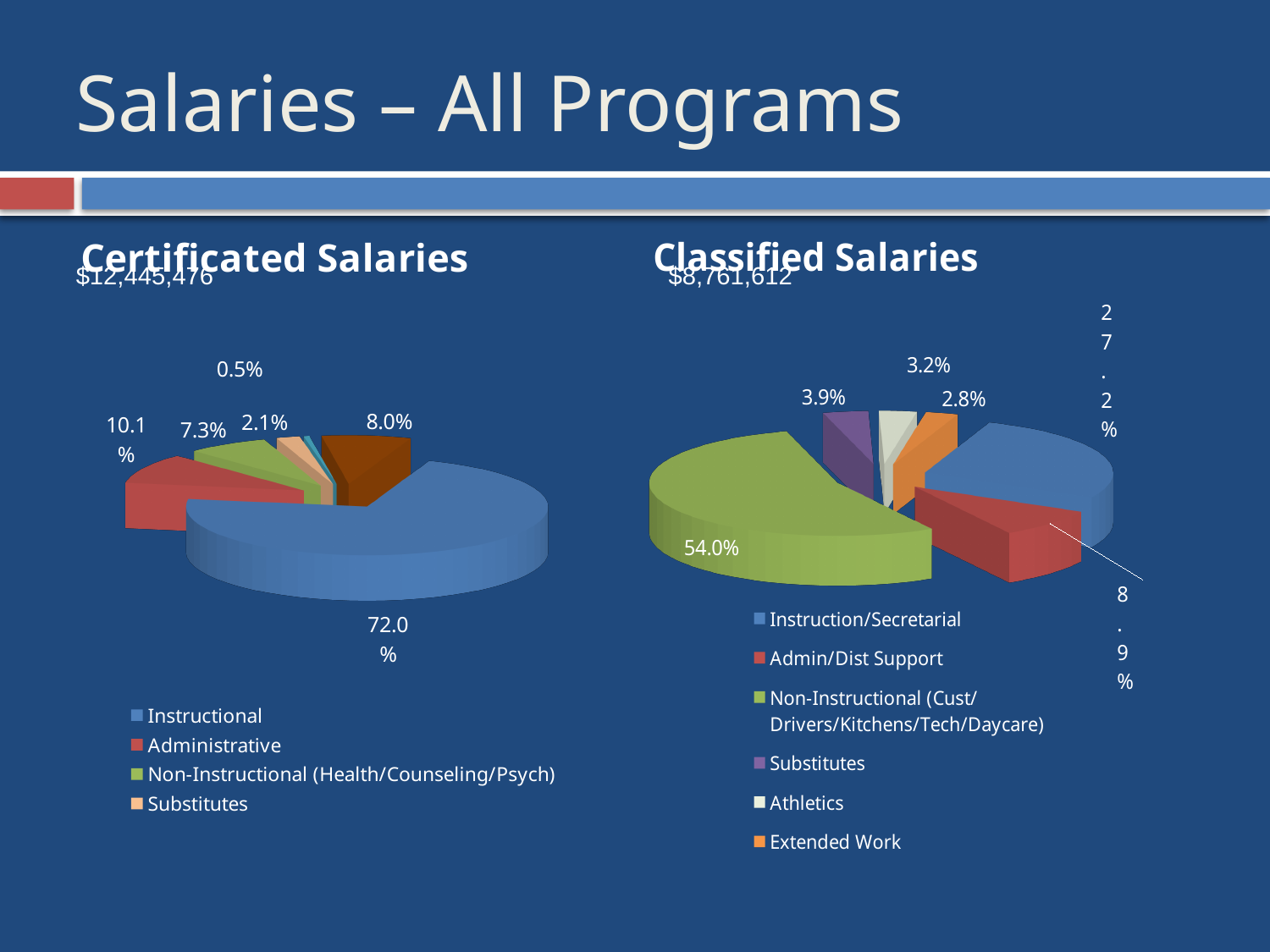
In the Certificated Salaries chart, which category has the largest slice? Instructional In the Certificated Salaries chart, what share is Instructional? 72.0% In the Classified Salaries chart, what share is Admin/Dist Support? 8.9% How many categories does the legend of the Classified Salaries chart list? 6 In the Classified Salaries chart, what share is Instruction/Secretarial? 27.2% In the Classified Salaries chart, which category has the smallest slice? Extended Work In the Certificated Salaries chart, which is larger, Administrative or Non-Instructional (Health/Counseling/Psych)? Administrative In the Classified Salaries chart, what is the difference in percentage points between Non-Instructional (Cust/Drivers/Kitchens/Tech/Daycare) and Instruction/Secretarial? 26.8 What kind of chart is the Certificated Salaries chart? Pie chart